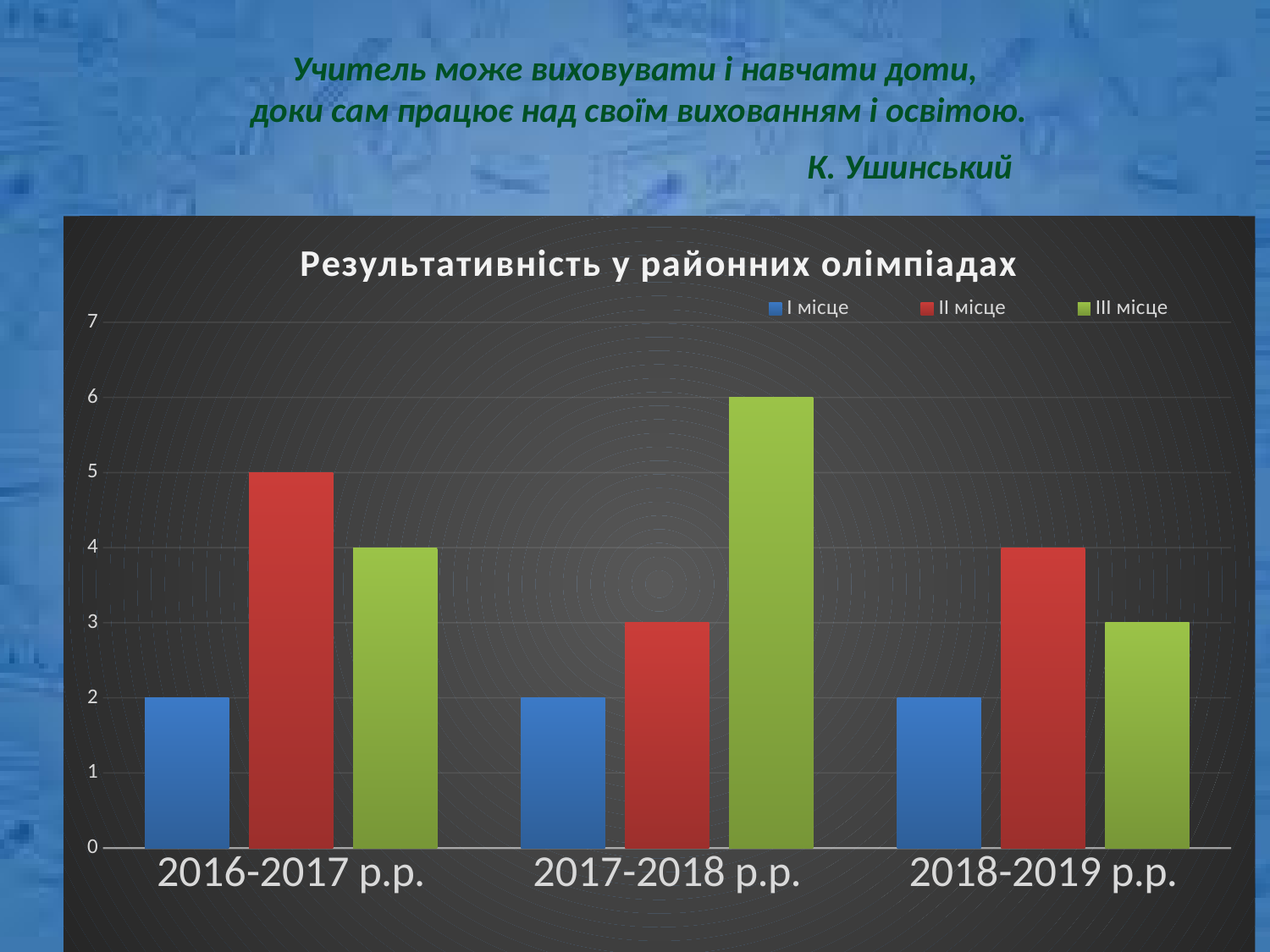
Which school year has the highest value for ІІІ місце? 2017-2018 р.р. How many series does the legend list? 3 What is the difference between ІІІ місце and ІІ місце in 2017-2018 р.р.? 3 What type of chart is shown on the slide? bar chart What is the value for І місце in 2018-2019 р.р.? 2 What is the title of the chart? Результативність у районних олімпіадах Which is larger in 2018-2019 р.р.: ІІ місце or ІІІ місце? ІІ місце How many categories (school years) are shown on the x axis? 3 Does the value for І місце change across the three school years? No, it stays at 2 What is the value for ІІІ місце in 2017-2018 р.р.? 6 What is the value for ІІ місце in 2016-2017 р.р.? 5 Which school year has the lowest value for ІІ місце? 2017-2018 р.р.